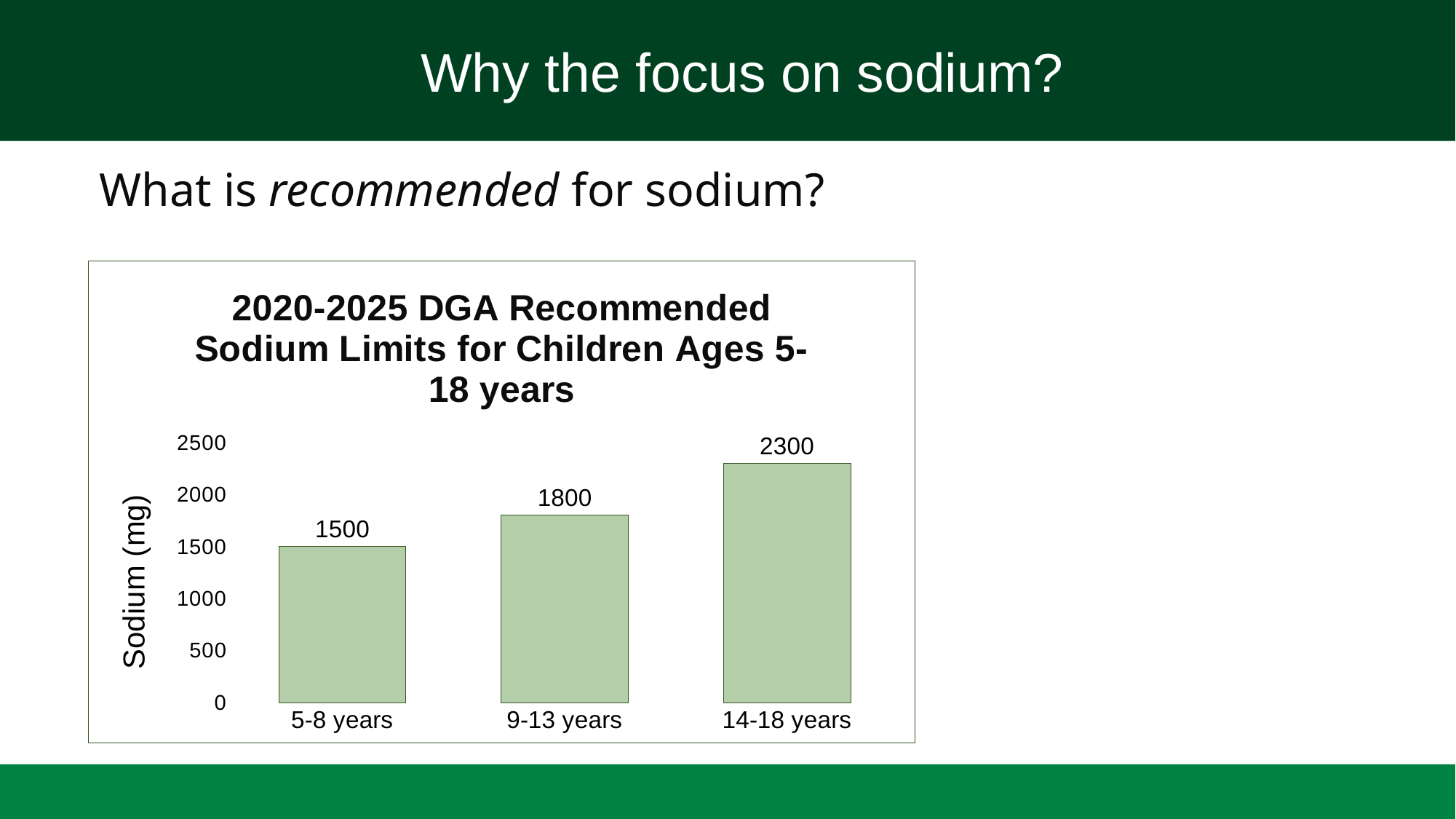
What is the difference between the sodium limits for 9-13 years and 5-8 years? 300 What is the recommended sodium limit for children aged 9-13 years? 1800 What kind of chart is shown on the slide? bar chart How many age groups are shown in the chart? 3 Which age group has the lowest recommended sodium limit? 5-8 years Which age group has the highest recommended sodium limit? 14-18 years What is the difference between the sodium limits for 14-18 years and 5-8 years? 800 What is the recommended sodium limit for children aged 14-18 years? 2300 What is the recommended sodium limit for children aged 5-8 years? 1500 Which age group has a larger sodium limit, 9-13 years or 14-18 years? 14-18 years Do the recommended sodium limits rise or fall as the age groups get older? rise Is the sodium limit for 9-13 years greater or less than 2000? less